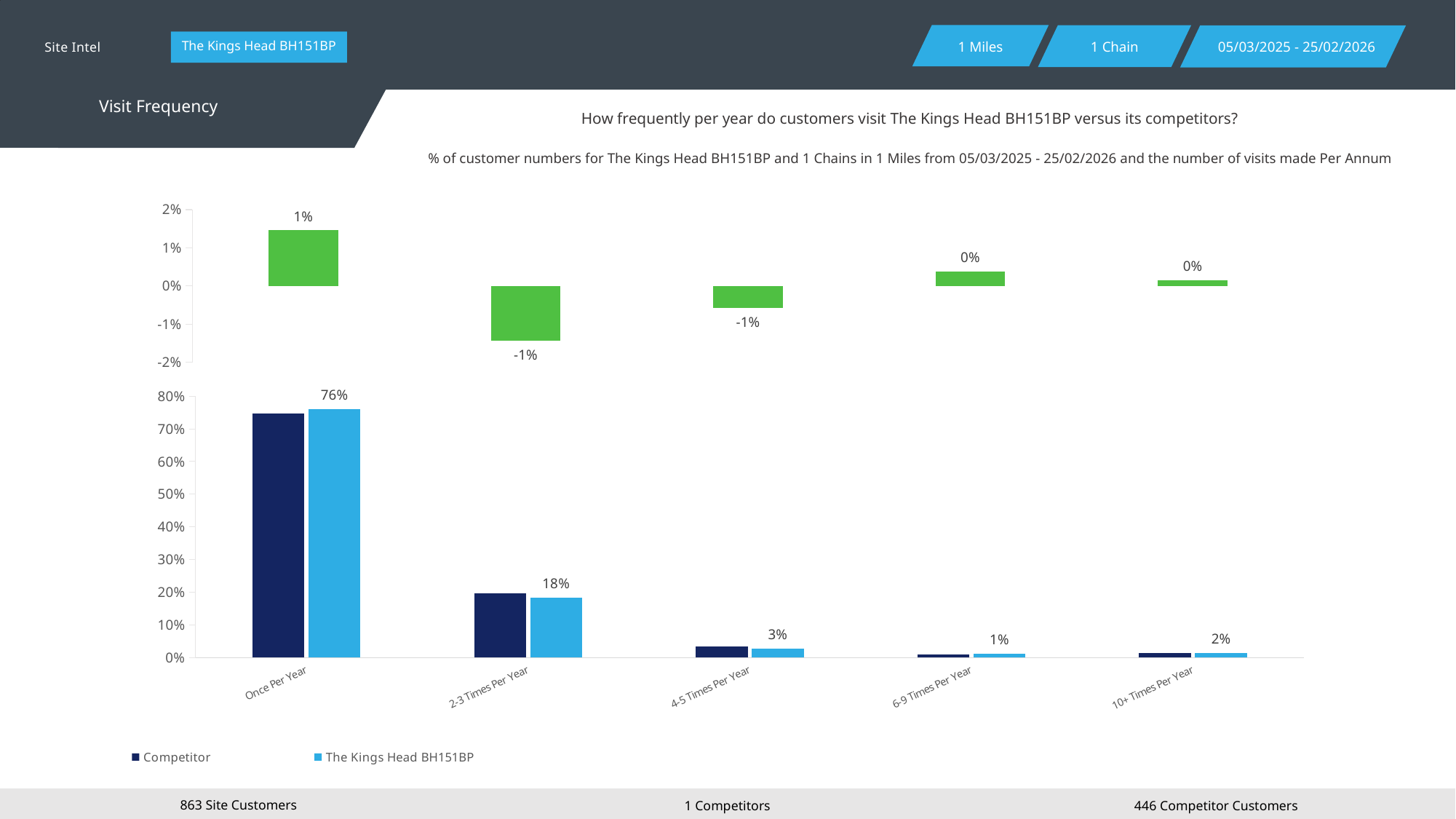
In the bottom chart, what is the value for The Kings Head BH151BP for 4-5 Times Per Year? 3% In the bottom chart, what is the value for The Kings Head BH151BP for 2-3 Times Per Year? 18% In the bottom chart, how many series does the legend list? 2 In the bottom chart, which category has the highest value for The Kings Head BH151BP? Once Per Year In the top chart, what is the value shown for the 2-3 Times Per Year category? -1% In the bottom chart, which category has the lowest value for The Kings Head BH151BP? 6-9 Times Per Year In the bottom chart, how many categories are shown on the x axis? 5 In the bottom chart, is the Competitor value for Once Per Year greater or less than 70%? greater In the bottom chart, what is the value for The Kings Head BH151BP for 10+ Times Per Year? 2% In the bottom chart, what is the difference between The Kings Head BH151BP values for Once Per Year and 2-3 Times Per Year? 58% In the bottom chart, what is the value for The Kings Head BH151BP for Once Per Year? 76% What kind of chart is the bottom chart? Bar chart